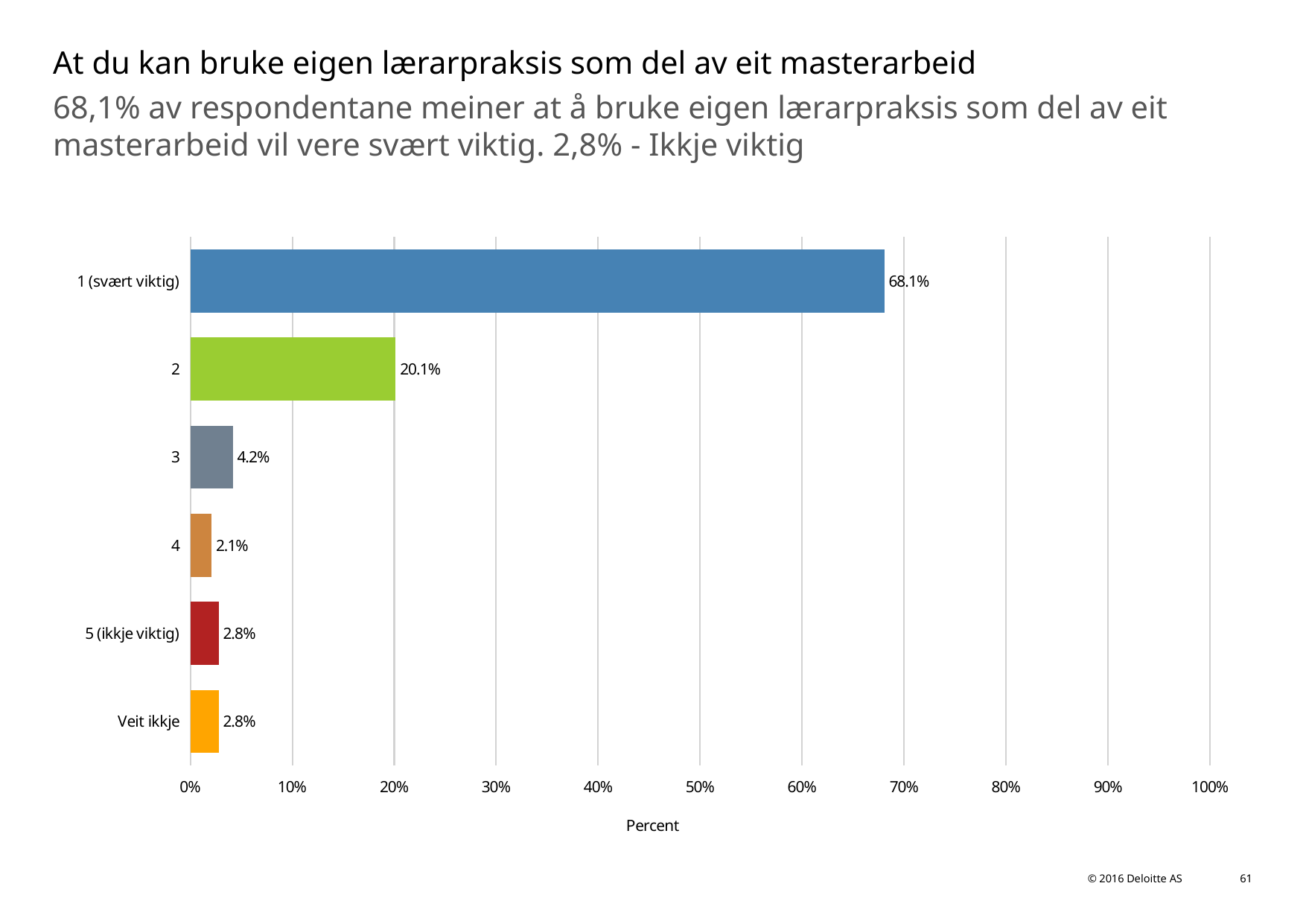
What is the value for "1 (svært viktig)"? 68.1% Is the value for "2" greater or less than 30%? less Which is larger, the value for "3" or the value for "4"? 3 What is the value for category "2"? 20.1% Which category has the highest value? 1 (svært viktig) What kind of chart is shown on the slide? bar chart What is the value for category "3"? 4.2% What is the value for "Veit ikkje"? 2.8% How many categories are shown in the chart? 6 What is the difference between the values for "1 (svært viktig)" and "2"? 48.0% What is the label of the horizontal axis? Percent Which category has the lowest value? 4